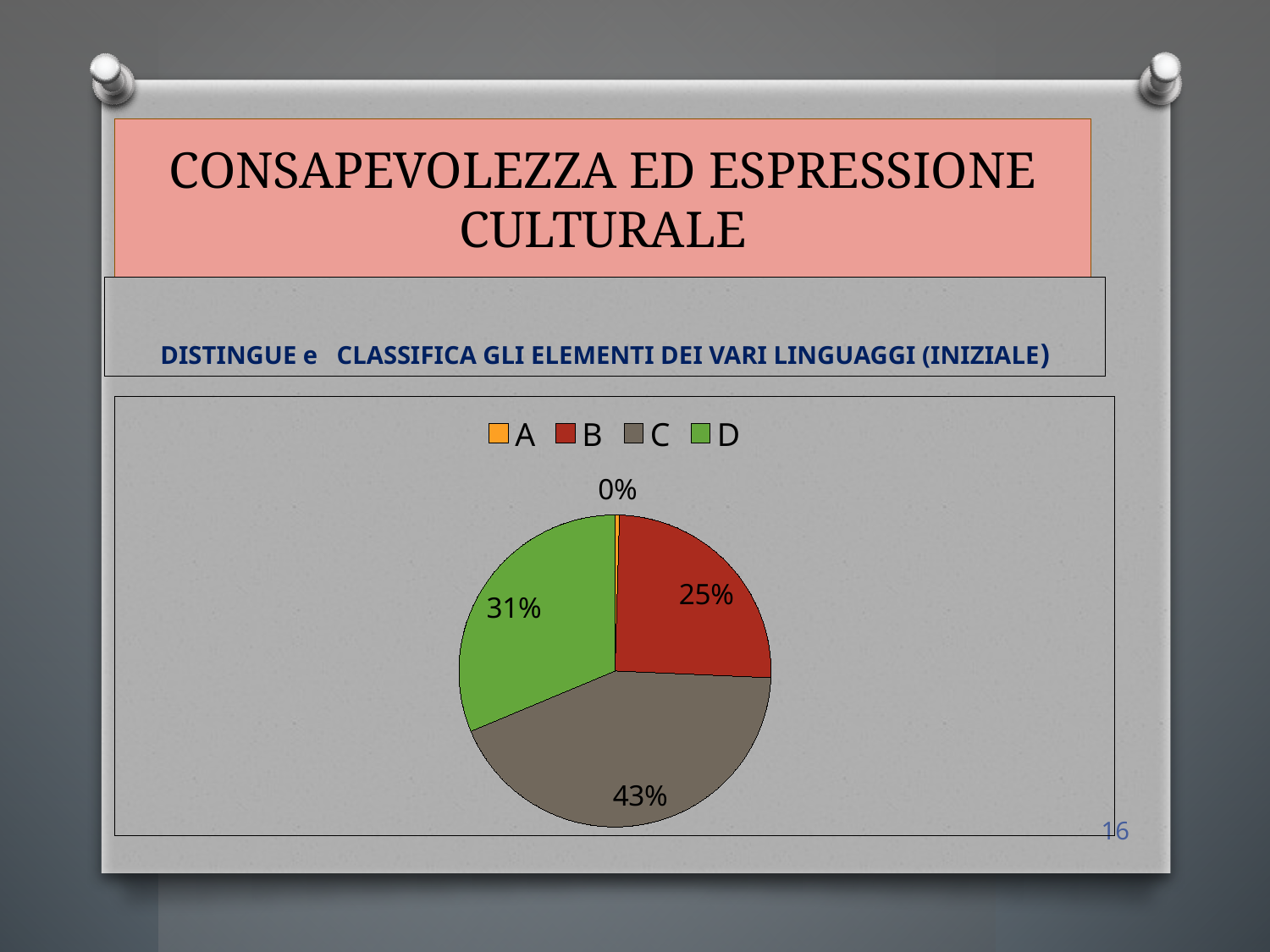
What percentage does slice B represent? 25% What kind of chart is shown on the slide? pie chart Which category has the largest share of the pie? C What percentage does slice A represent? 0% Which is larger, the share for D or the share for B? D What percentage does slice D represent? 31% What percentage does slice C represent? 43% Which category has the smallest share of the pie? A What is the difference in percentage points between slice D and slice B? 6 What colour is the slice for category C? grey What is the difference in percentage points between slice C and slice B? 18 How many categories does the legend list? 4